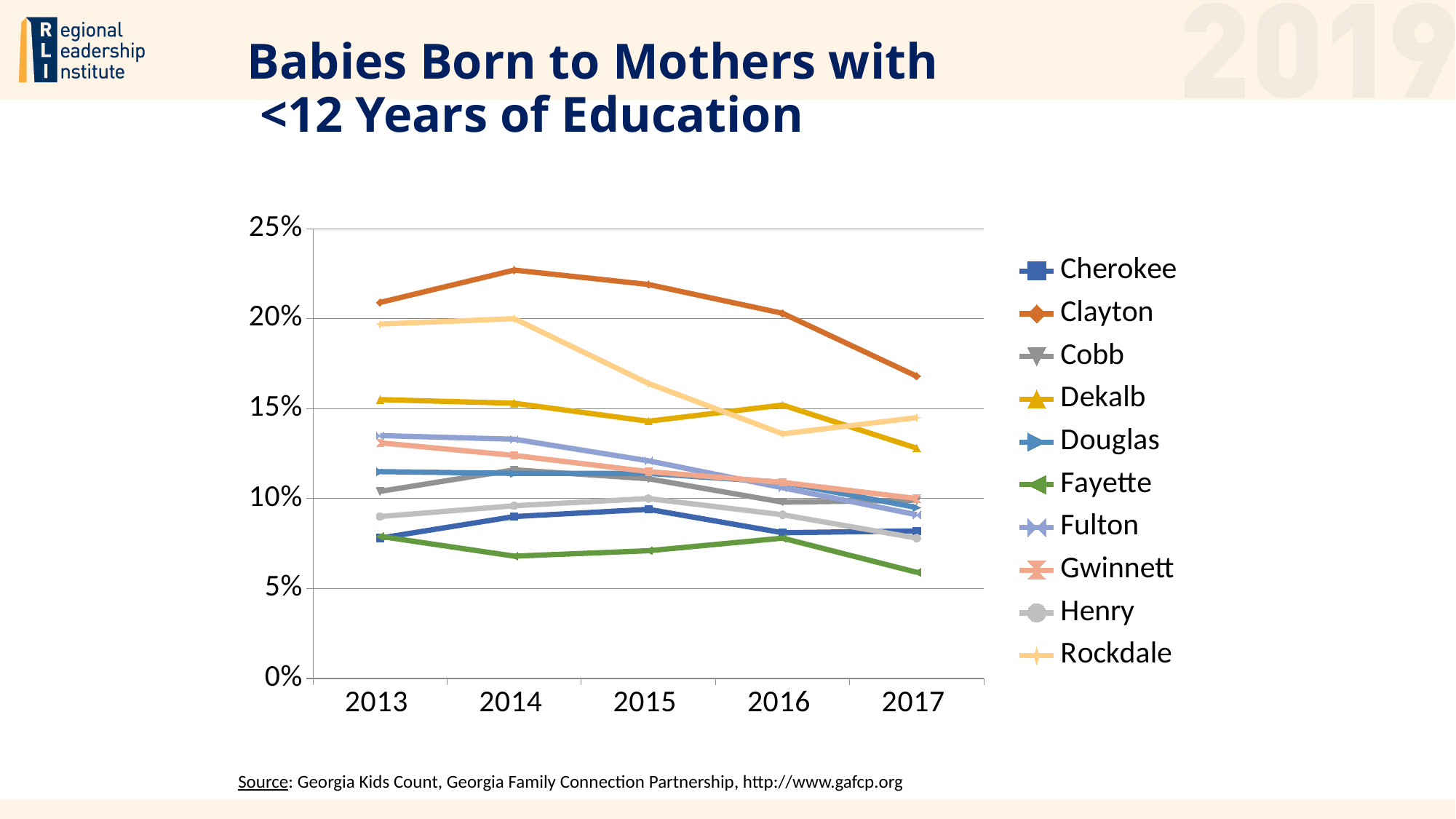
Which county has the highest value in 2017? Clayton How many years are shown along the x axis? 5 Which county has the lowest value in 2017? Fayette What is the first year shown on the x axis? 2013 Is the value for Clayton in 2014 greater or less than 20%? greater Is the value for Rockdale in 2016 greater or less than 15%? less Which county has the highest value in 2013? Clayton What kind of chart is shown on the slide? line chart Which is larger in 2013, the value for Clayton or the value for Rockdale? Clayton How many series does the legend list? 10 Does the value for Clayton rise or fall from 2014 to 2017? fall Is the value for Fayette in 2017 greater or less than 10%? less